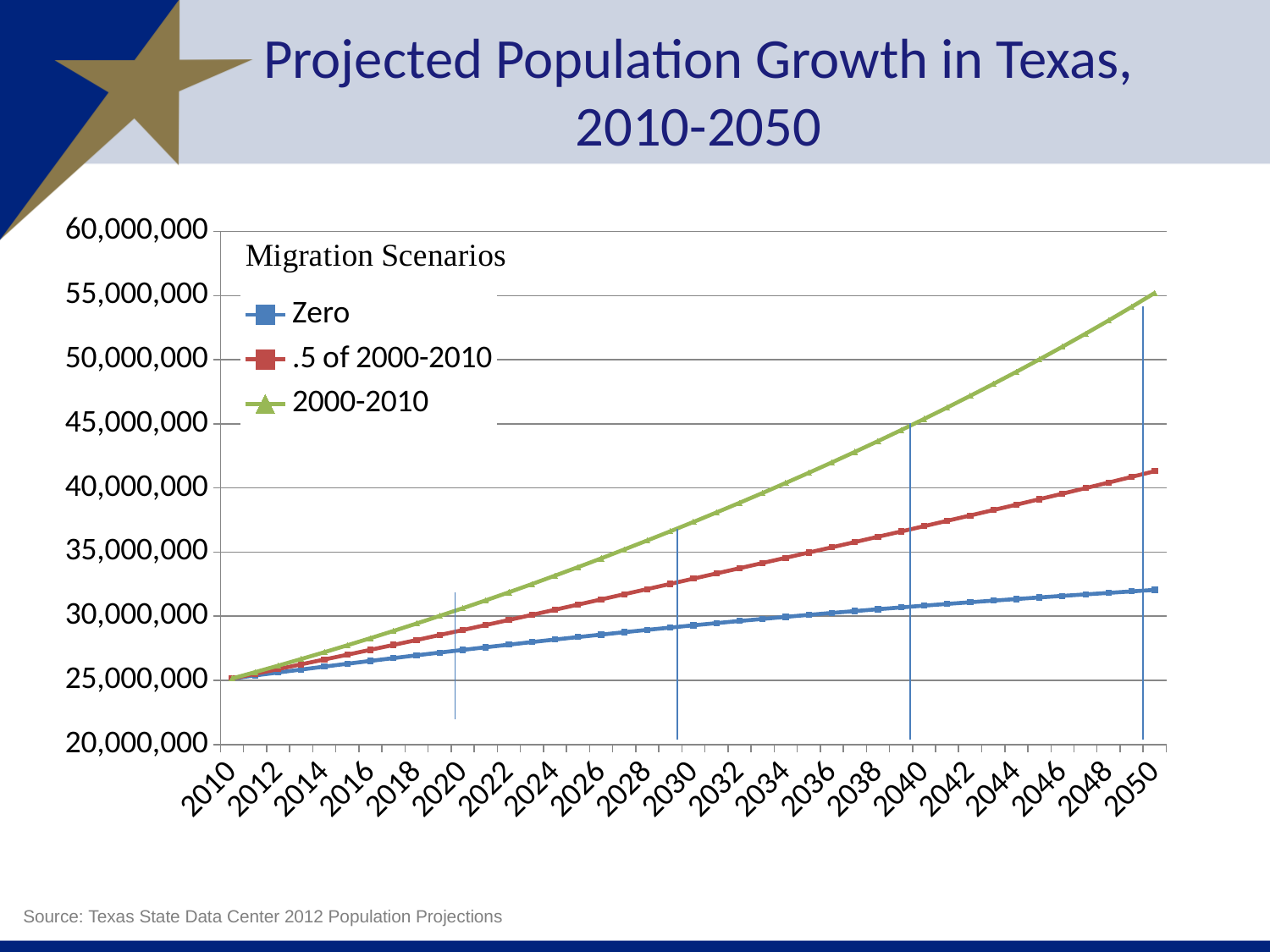
Do the values for the 2000-2010 scenario rise or fall from 2010 to 2050? rise Which migration scenario has the lowest projected population in 2050? Zero What is the title of the chart? Projected Population Growth in Texas, 2010-2050 What heading appears above the legend entries? Migration Scenarios Which migration scenario has the highest projected population in 2050? 2000-2010 How many year labels are shown on the x axis? 21 Is the value for the .5 of 2000-2010 scenario in 2040 greater or less than 35,000,000? greater Is the value for the Zero scenario in 2030 greater or less than 30,000,000? less In 2040, which is larger: the value for the .5 of 2000-2010 scenario or the Zero scenario? .5 of 2000-2010 What kind of chart is shown on the slide? line chart How many series does the legend list? 3 Is the value for the 2000-2010 scenario in 2030 greater or less than 35,000,000? greater